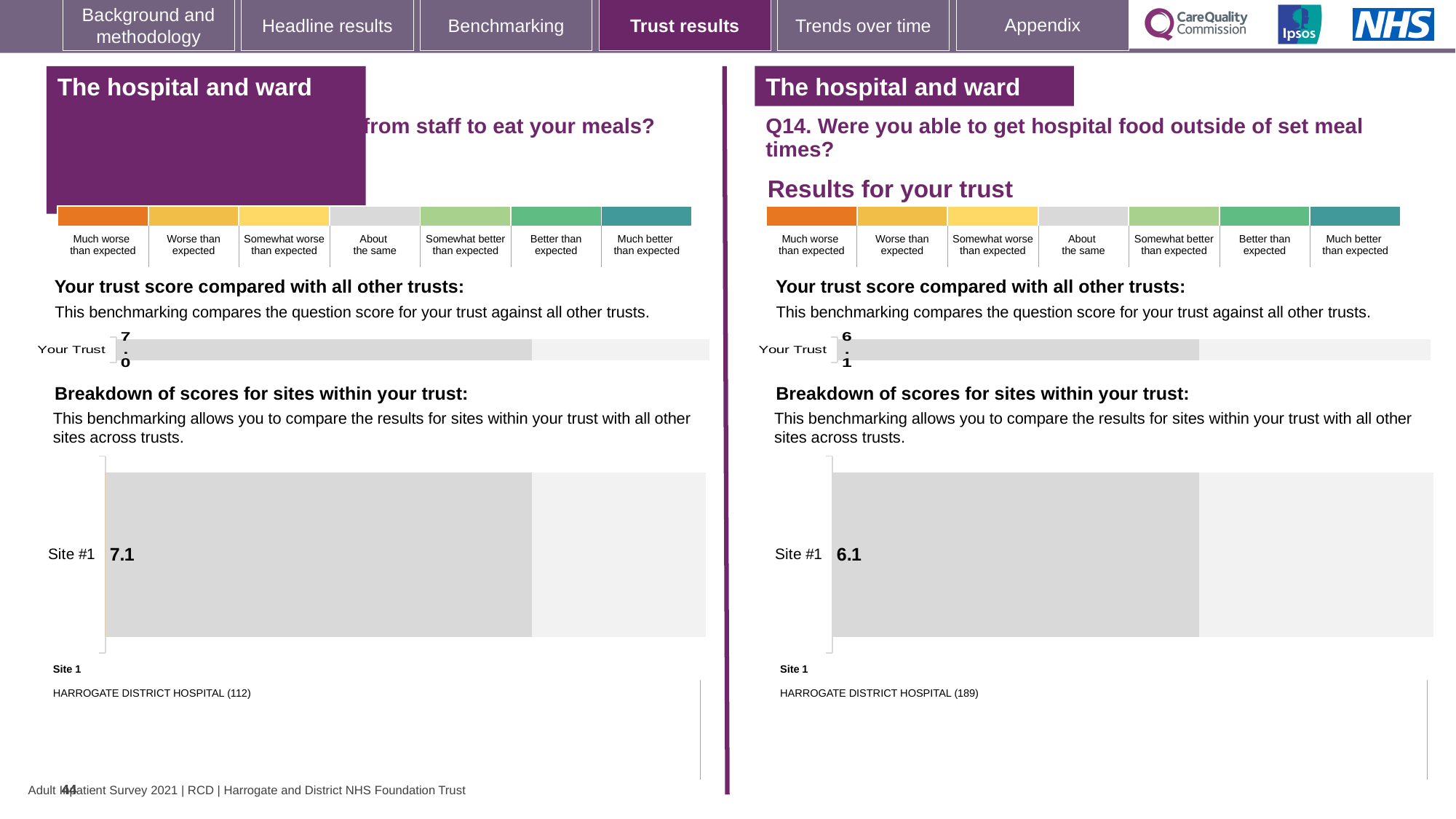
On the left-hand site breakdown chart, which hospital is listed as Site 1? HARROGATE DISTRICT HOSPITAL (112) What is the difference between the Site #1 score on the left-hand site breakdown chart (7.1) and the Site #1 score on the right-hand Q14 site breakdown chart (6.1)? 1.0 On the right-hand chart for Q14 (hospital food outside of set meal times), what is the 'Your Trust' score? 6.1 What is the difference between the 'Your Trust' score on the left-hand chart (7.0) and the 'Your Trust' score on the right-hand Q14 chart (6.1)? 0.9 On the left-hand 'Breakdown of scores for sites within your trust' chart, what is the score for Site #1? 7.1 How many sites are shown on the right-hand 'Breakdown of scores for sites within your trust' chart for Q14? 1 On the left-hand 'Your trust score compared with all other trusts' chart, what is the 'Your Trust' score? 7.0 What type of chart is used for the 'Breakdown of scores for sites within your trust' on the left-hand side? Bar chart On the right-hand Q14 site breakdown chart, how many respondents are shown in brackets for Site 1, Harrogate District Hospital? 189 On the right-hand 'Breakdown of scores for sites within your trust' chart for Q14, what is the score for Site #1? 6.1 Which is larger: the Site #1 score on the left-hand site breakdown chart or the Site #1 score on the right-hand (Q14) site breakdown chart? Left-hand chart (7.1)